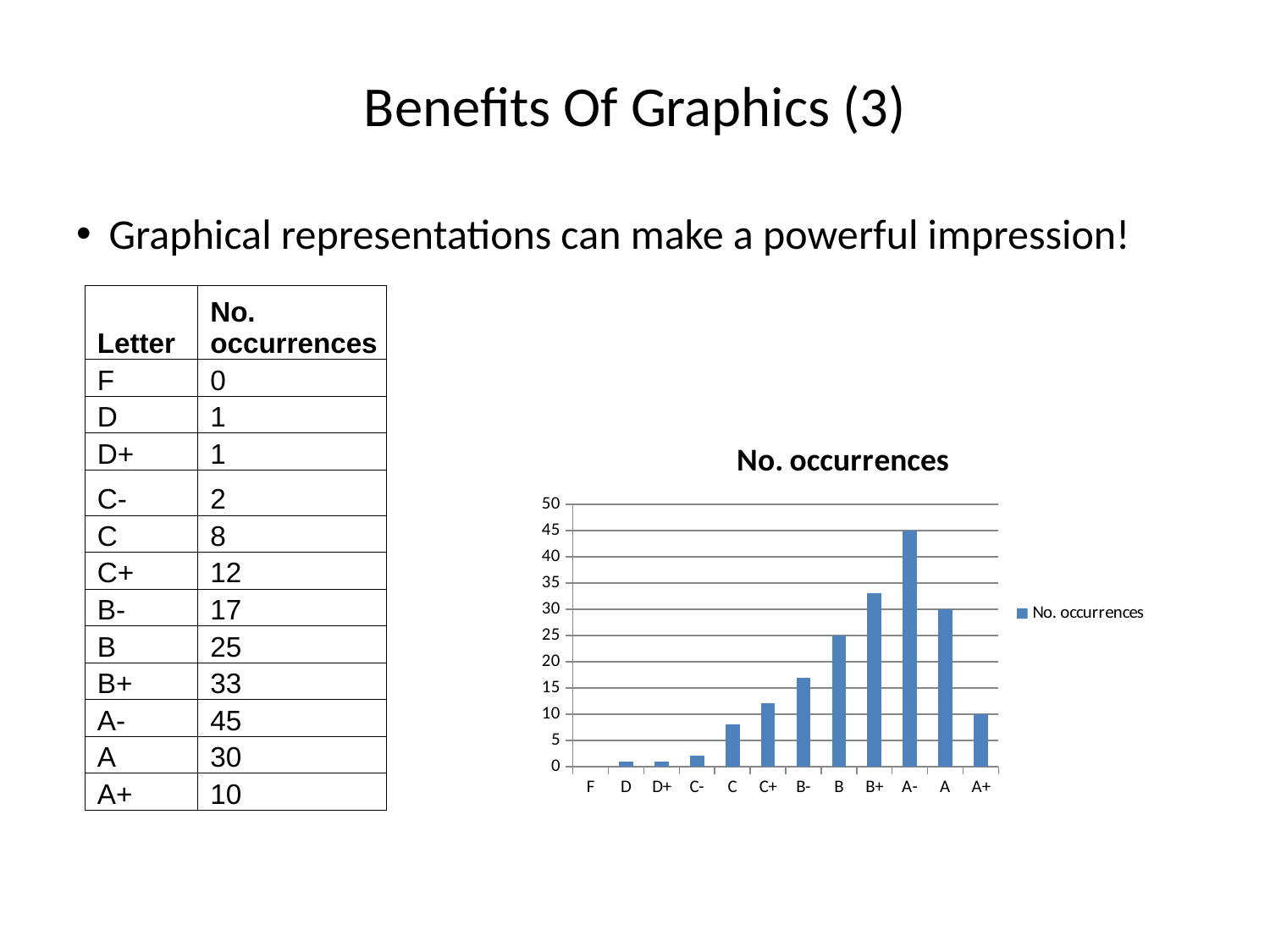
How many letter grade categories are shown on the x axis of the chart? 12 What is the number of occurrences for A+ in the chart? 10 How many series does the chart legend list? 1 What is the title of the chart? No. occurrences Which letter grade has the lowest number of occurrences in the chart? F What is the number of occurrences for A in the chart? 30 Which letter grade has the highest number of occurrences in the chart? A- Which has more occurrences in the chart, B or A? A What is the number of occurrences for A- in the chart? 45 Is the value for B+ in the chart greater or less than 30? greater What kind of chart is shown on the slide? bar chart What is the difference between the number of occurrences for A- and A in the chart? 15